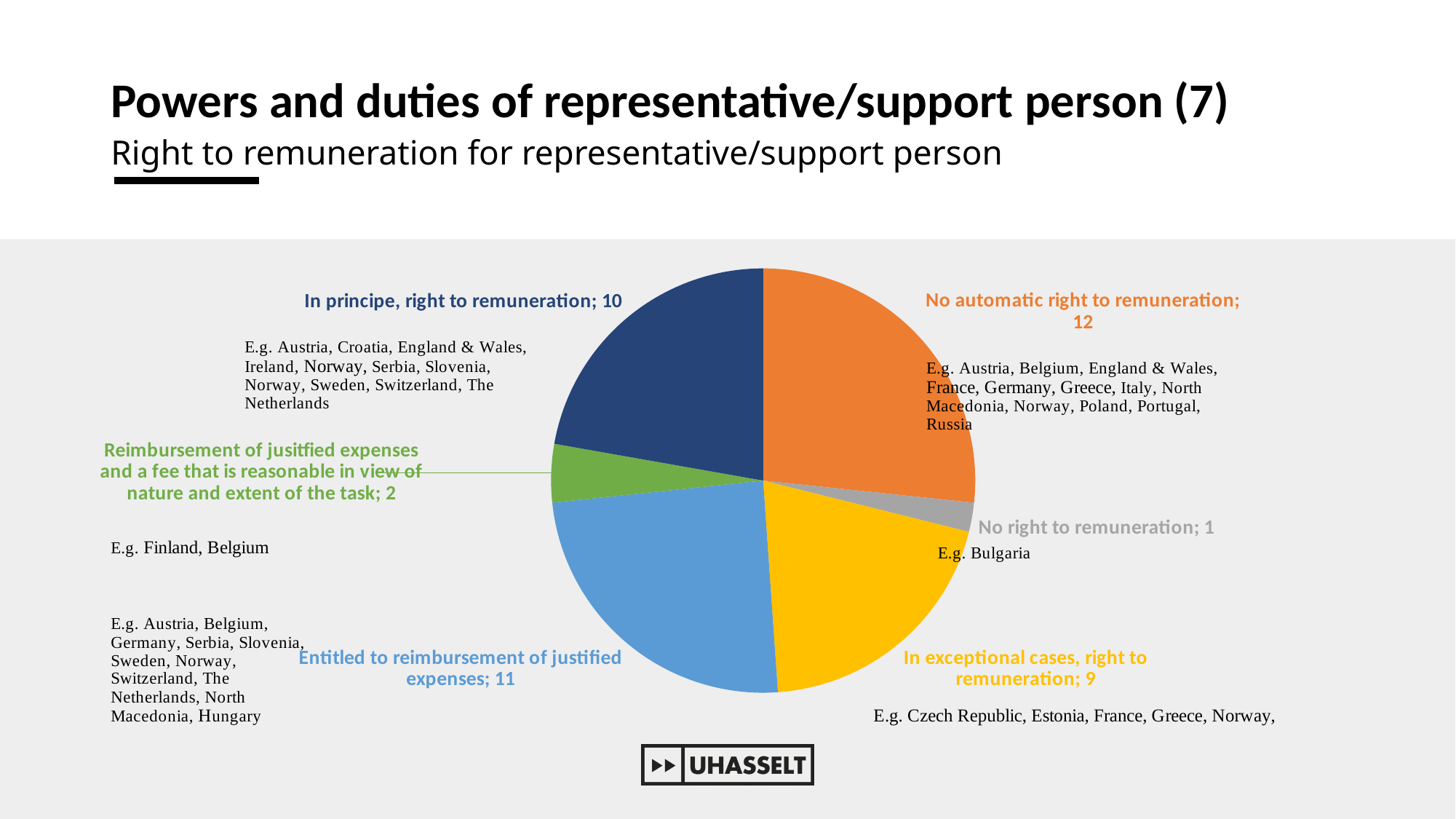
What is the difference between the values for "No automatic right to remuneration" and "In principe, right to remuneration"? 2 What is the value for "No right to remuneration"? 1 What is the value for "No automatic right to remuneration"? 12 Which country is given as the example for "No right to remuneration"? Bulgaria How many slices does the pie chart have? 6 What is the value for "Entitled to reimbursement of justified expenses"? 11 What kind of chart is shown on the slide? Pie chart Which category has the smallest slice of the pie? No right to remuneration Which category has the largest slice of the pie? No automatic right to remuneration Which is larger: "Entitled to reimbursement of justified expenses" or "In exceptional cases, right to remuneration"? Entitled to reimbursement of justified expenses What share of the pie does "In exceptional cases, right to remuneration" represent? 20% What is the value for "In exceptional cases, right to remuneration"? 9